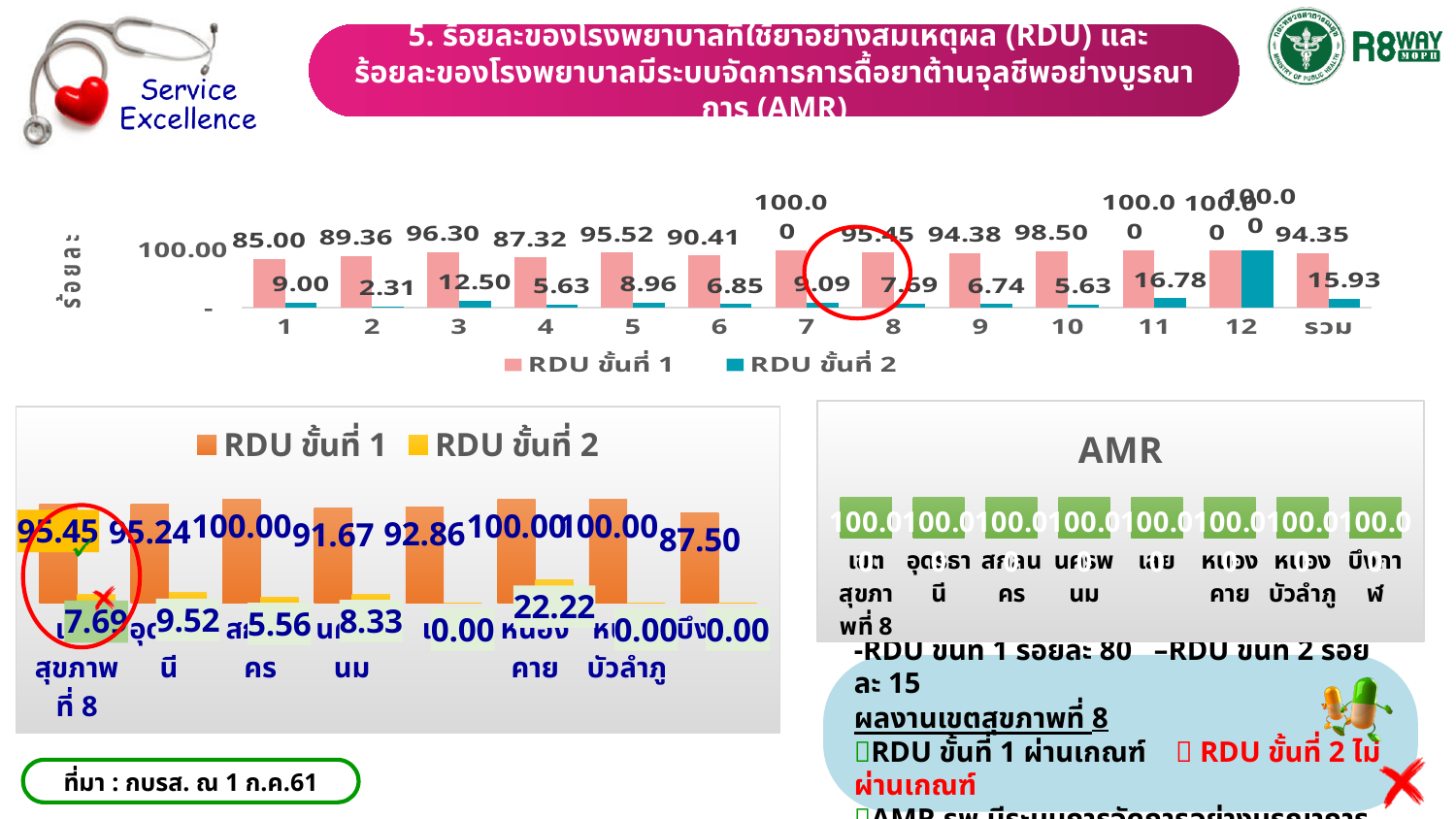
In the top chart, what is the value of RDU ขั้นที่ 1 for รวม? 94.35 In the top chart, what is the difference between RDU ขั้นที่ 1 and RDU ขั้นที่ 2 for category 8? 87.76 In the top chart, which is larger: RDU ขั้นที่ 1 for category 3 or for category 4? category 3 In the top chart, what is the value of RDU ขั้นที่ 2 for category 11? 16.78 What kind of chart is the top chart? bar chart In the bottom-left chart, what is the value of RDU ขั้นที่ 2 for หนองคาย? 22.22 In the bottom-right AMR chart, what is the value for อุดรธานี? 100.0 In the top chart, what is the value of RDU ขั้นที่ 1 for category 1? 85.00 In the bottom-left chart, which category has the lowest RDU ขั้นที่ 1 value? บึงกาฬ How many series does the legend of the top chart list? 2 In the top chart, which category has the lowest RDU ขั้นที่ 2 value? 2 In the bottom-left chart, what is the value of RDU ขั้นที่ 1 for นครพนม? 91.67